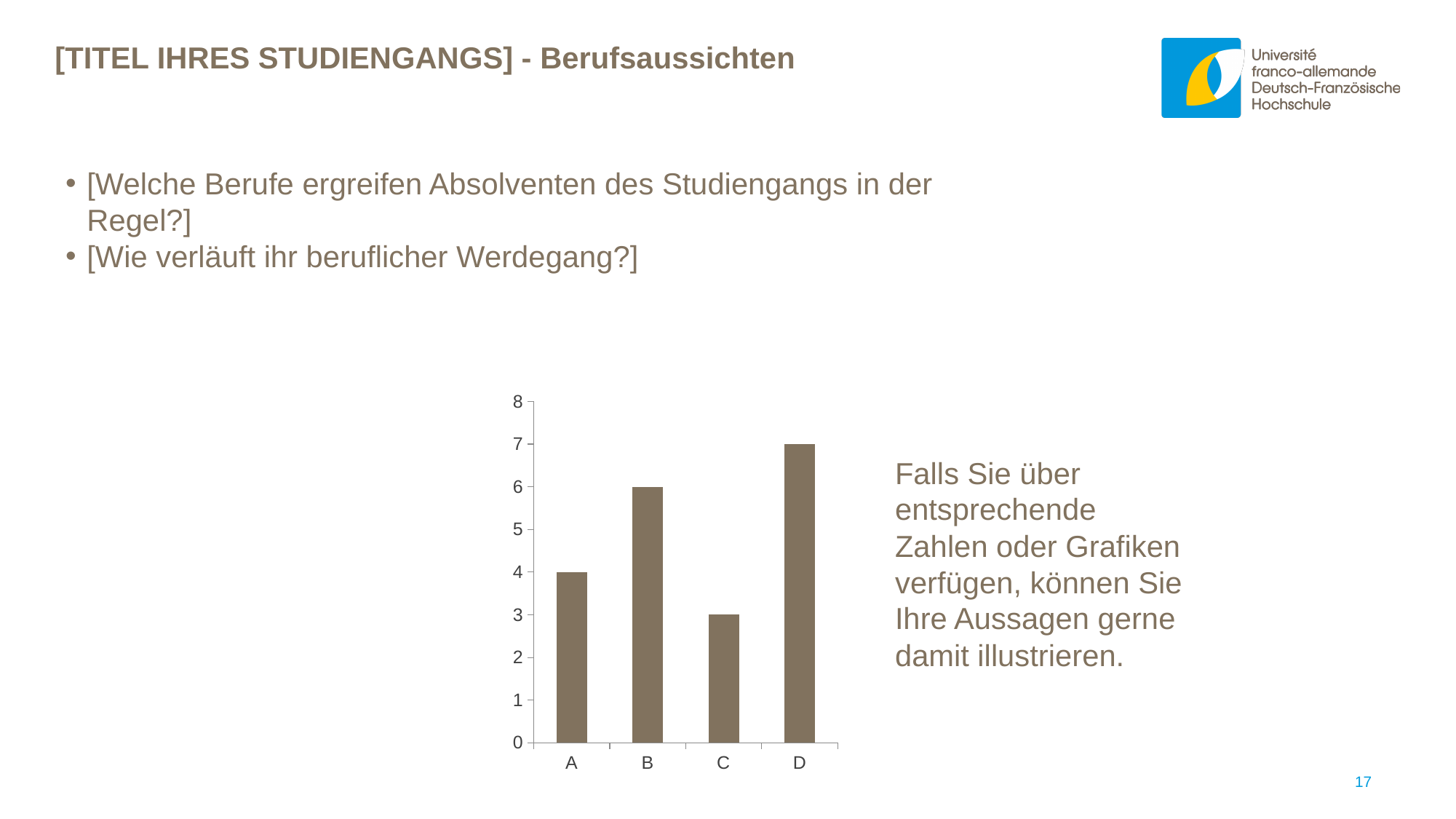
What is the highest value shown on the y axis of the chart? 8 What type of chart is shown on the slide? bar chart What is the value for category A? 4 What is the difference between the values for D and A? 3 How many categories are shown on the x axis of the chart? 4 Which category has the highest value? D Is the value for D greater or less than 5? greater What is the value for category D? 7 What is the value for category C? 3 What is the value for category B? 6 Which category has the lowest value? C Which is larger, the value for B or the value for C? B